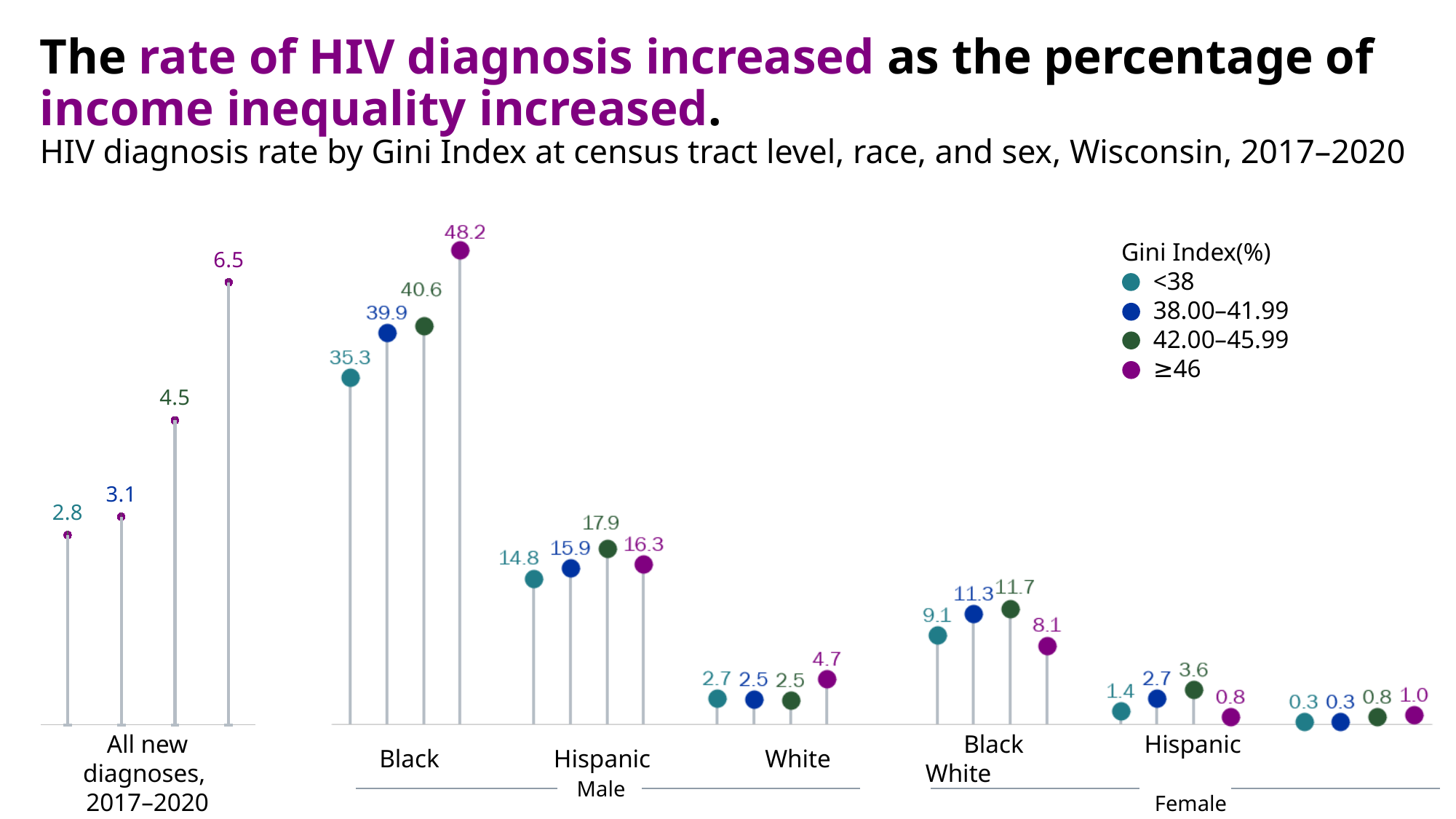
What is the difference between the HIV diagnosis rate for White males with a Gini Index of ≥46 and those with a Gini Index of <38? 2.0 Does the HIV diagnosis rate for all new diagnoses, 2017–2020, rise or fall as the Gini Index category increases? rise What is the title of the legend on the chart? Gini Index(%) What is the HIV diagnosis rate for Black males in census tracts with a Gini Index of 42.00–45.99? 40.6 How many Gini Index categories does the legend list? 4 What is the HIV diagnosis rate for all new diagnoses, 2017–2020, in census tracts with a Gini Index of ≥46? 6.5 Which Gini Index category has the lowest HIV diagnosis rate among Hispanic females? ≥46 What is the difference between the HIV diagnosis rate for Black males with a Gini Index of ≥46 and those with a Gini Index of <38? 12.9 Which is larger: the HIV diagnosis rate for Hispanic males with a Gini Index of 42.00–45.99 or with a Gini Index of ≥46? 42.00–45.99 Which Gini Index category has the highest HIV diagnosis rate among Black males? ≥46 What is the HIV diagnosis rate for Black females in census tracts with a Gini Index of 38.00–41.99? 11.3 What is the HIV diagnosis rate for Hispanic males in census tracts with a Gini Index of <38? 14.8